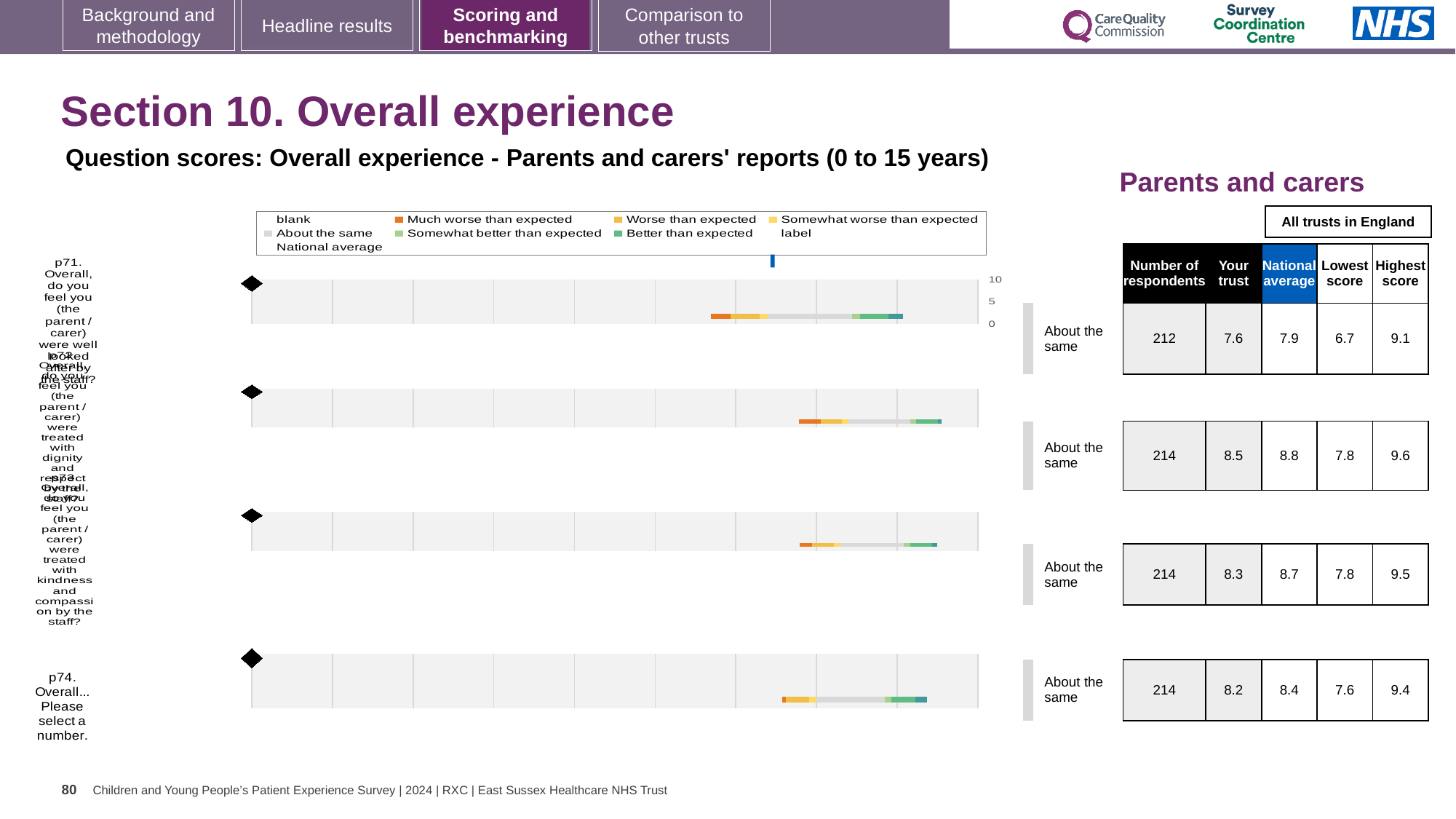
Is the 'Your trust' score for the bottom row (p74) larger or smaller than its national average? smaller What is the number of respondents for the top row (p71)? 212 What is the national average score for the top row (p71)? 7.9 Which row has the lowest 'Your trust' score? the top row, p71 (7.6) What kind of chart is shown on the slide? bar chart What benchmark category is shown for all four rows? About the same How many entries does the chart legend list? 9 Which row has the highest 'Your trust' score? the second row (8.5) How many question rows (bars) are plotted in the chart? 4 What is the 'Your trust' score for the top row (p71, overall well looked after by the staff)? 7.6 What is the difference between the national average and the 'Your trust' score for the top row (p71)? 0.3 What is the 'Your trust' score for the bottom row (p74, Overall... Please select a number)? 8.2